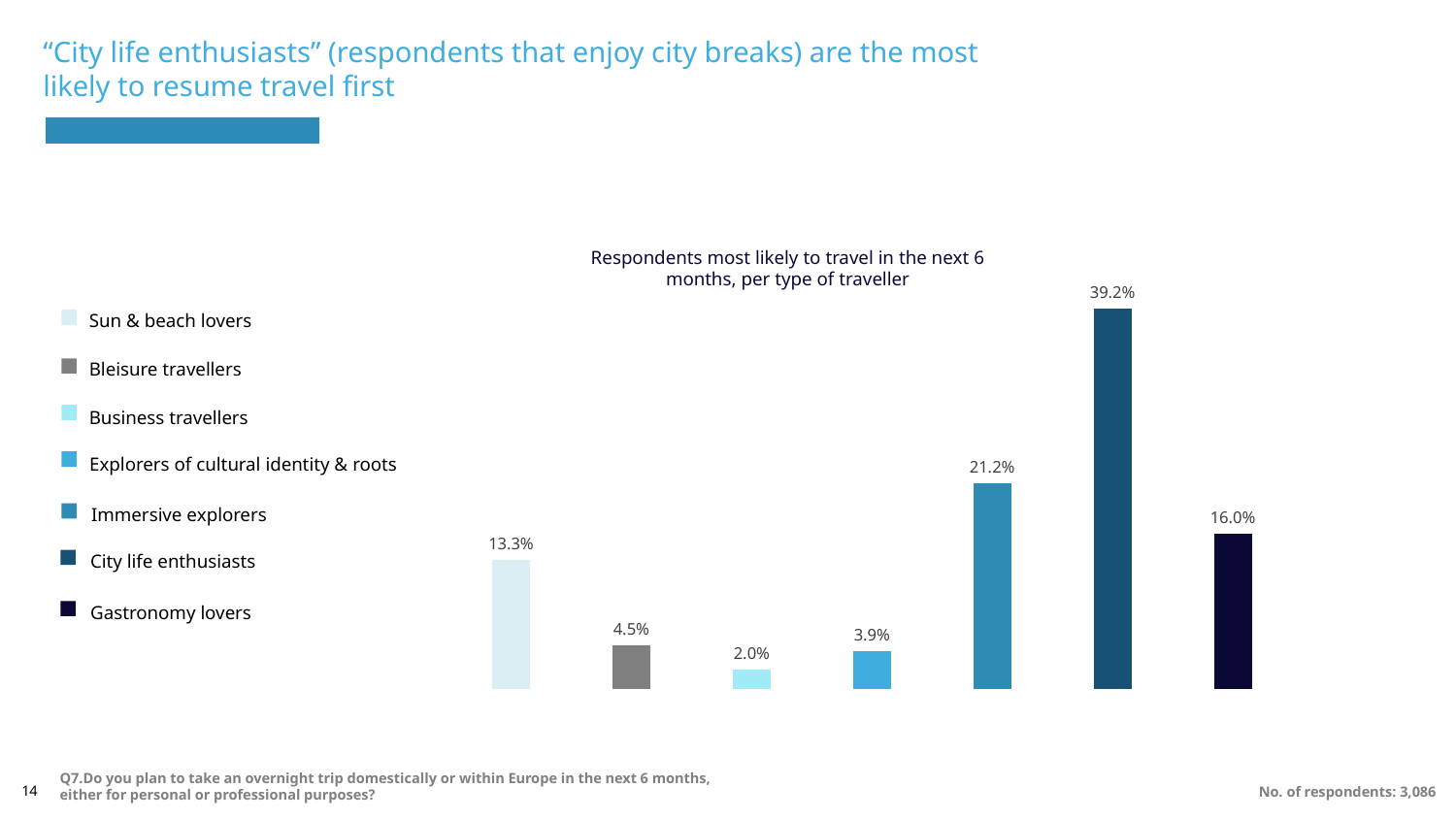
What is the difference between the values for Sun & beach lovers and Bleisure travellers? 8.8% What is the value shown for Gastronomy lovers? 16.0% What is the difference between the values for City life enthusiasts and Immersive explorers? 18.0% What is the value shown for Business travellers? 2.0% Which type of traveller has the highest value in the chart? City life enthusiasts What percentage of City life enthusiasts are most likely to travel in the next 6 months? 39.2% How many types of traveller are plotted in the chart? 7 What is the title of the chart? Respondents most likely to travel in the next 6 months, per type of traveller Which type of traveller has the lowest value in the chart? Business travellers What kind of chart is shown on the slide? Bar chart What is the value shown for Immersive explorers? 21.2% Which is larger, the value for Gastronomy lovers or the value for Sun & beach lovers? Gastronomy lovers